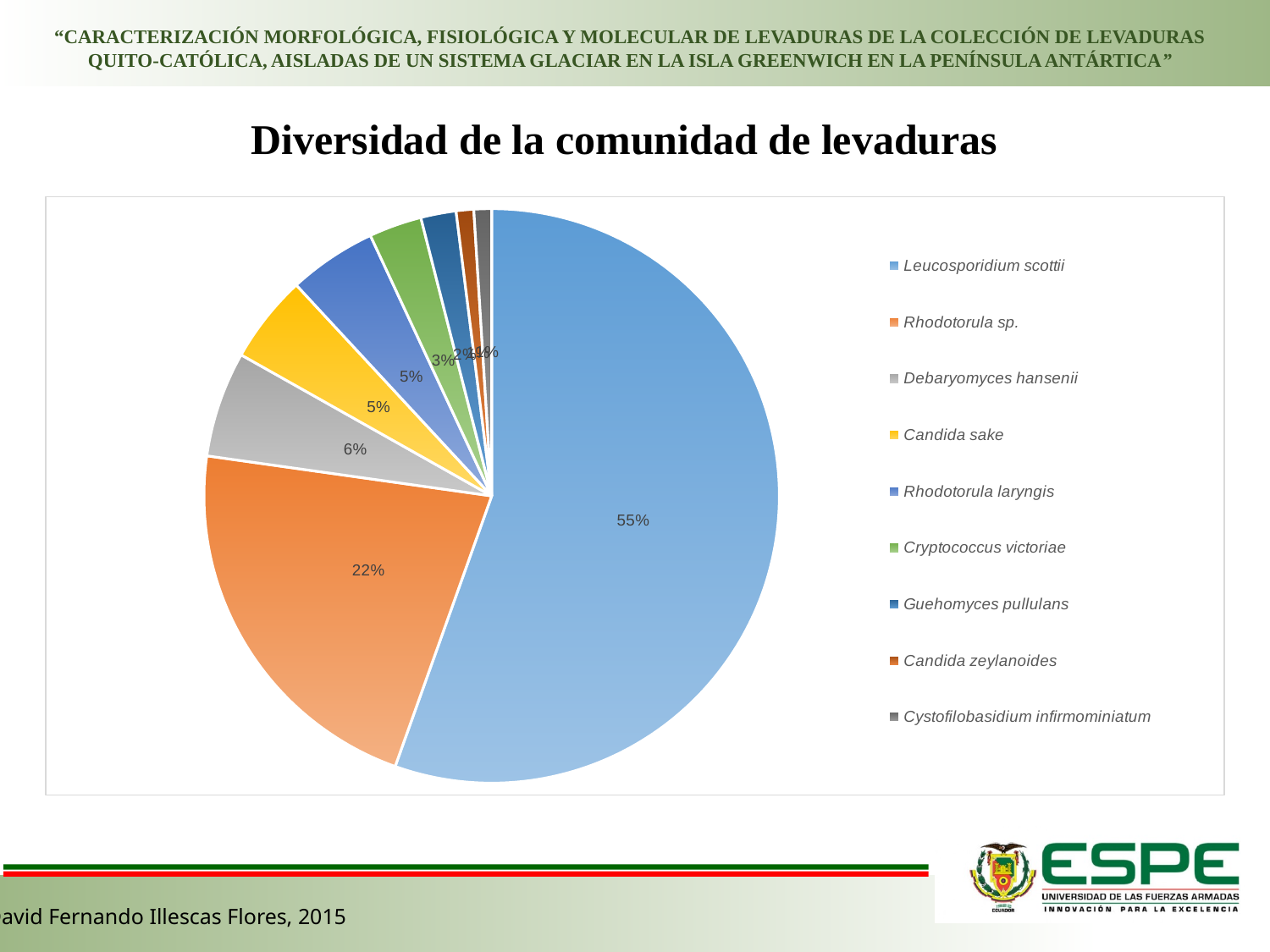
What kind of chart is shown on the slide? pie chart Which category is listed last in the legend? Cystofilobasidium infirmominiatum What percentage is shown for Rhodotorula sp.? 22% What percentage is shown for Cryptococcus victoriae? 3% What share of the pie does Leucosporidium scottii represent? 55% What percentage is shown for Candida sake? 5% How many categories does the legend of the pie chart list? 9 What is the title of the chart? Diversidad de la comunidad de levaduras Which is larger, the slice for Rhodotorula sp. or the slice for Debaryomyces hansenii? Rhodotorula sp. What is the difference in percentage points between Leucosporidium scottii and Rhodotorula sp.? 33 Which category has the largest slice of the pie? Leucosporidium scottii What percentage is shown for Debaryomyces hansenii? 6%